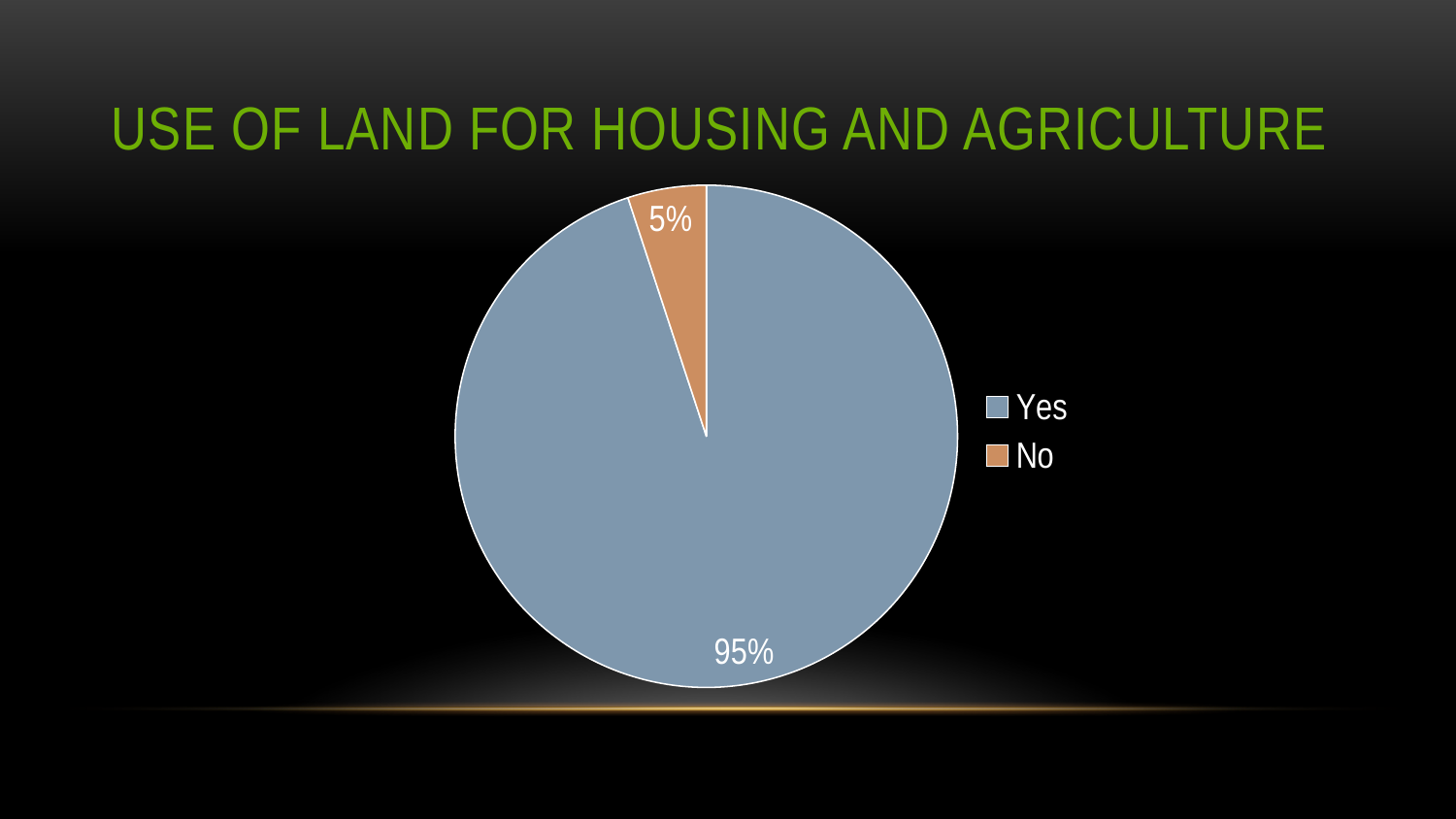
Which category has the smallest slice of the pie? No How many slices does the pie chart have? 2 What kind of chart is shown on the slide? pie chart What is the difference in percentage points between the "Yes" and "No" slices? 90 How many entries does the legend list? 2 What percentage of the pie is labelled "No"? 5% What is the title of the chart? USE OF LAND FOR HOUSING AND AGRICULTURE What percentage of the pie is labelled "Yes"? 95% What colour is the "No" slice of the pie? orange Which category has the largest slice of the pie? Yes Which slice is larger, "Yes" or "No"? Yes What share of the pie does the "Yes" slice represent? 95%